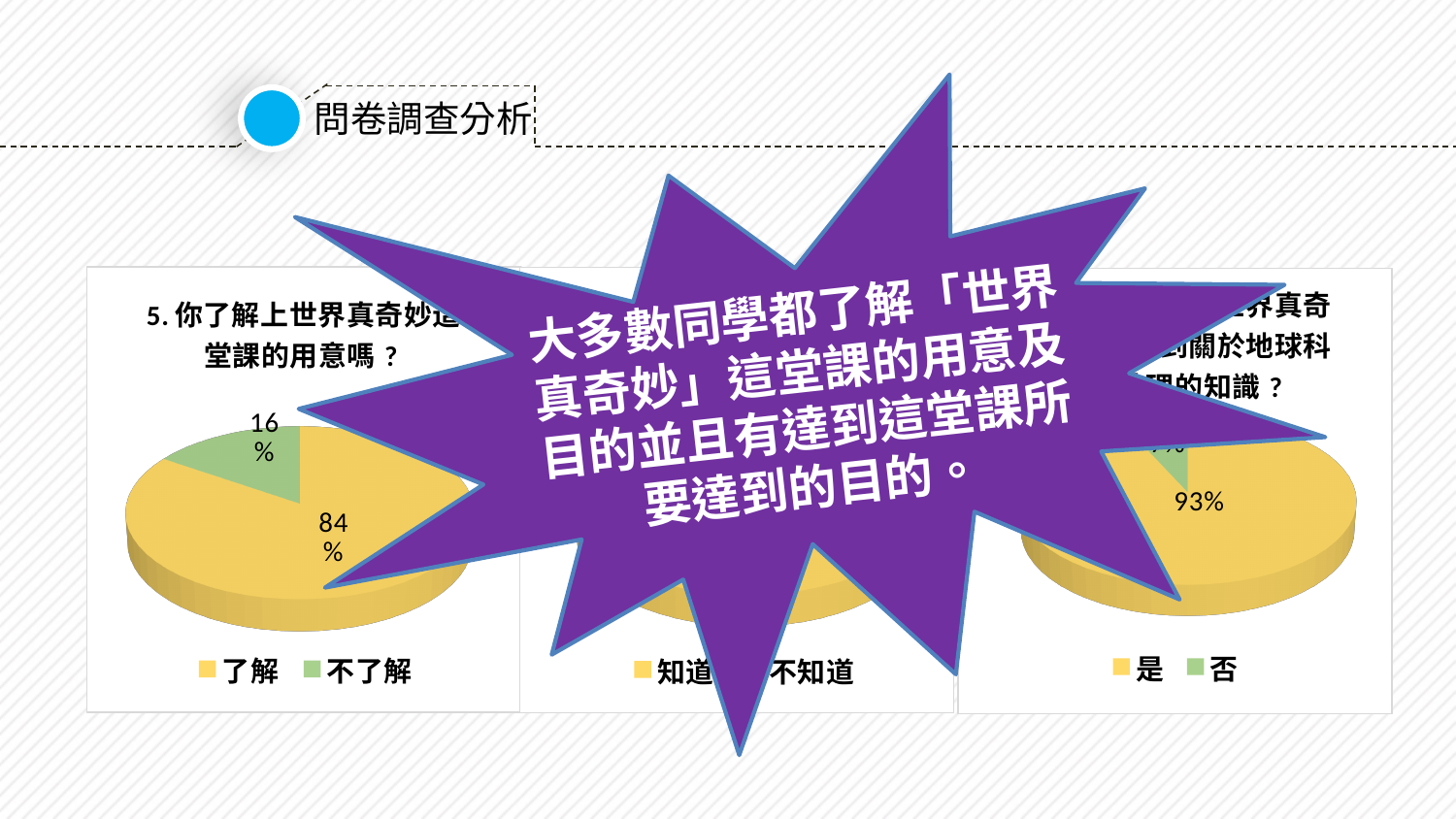
How many pie charts are shown on the slide? 3 On the left pie chart (question 5), which category has the largest share? 了解 On the right pie chart (with legend 是 / 否), which category has the largest share? 是 On the right pie chart (with legend 是 / 否), what percentage of students answered 是? 93% On the left pie chart (question 5), what percentage of students answered 不了解? 16% How many categories does the legend of the left pie chart (question 5) list? 2 On the left pie chart (question 5, 你了解上世界真奇妙這堂課的用意嗎), what percentage of students answered 了解? 84% What kind of chart is the left chart (question 5)? Pie chart On the left pie chart (question 5), which is larger: the share for 了解 or the share for 不了解? 了解 On the left pie chart (question 5), what is the difference in percentage points between 了解 and 不了解? 68 percentage points What are the two legend entries of the middle pie chart? 知道 and 不知道 On the left pie chart (question 5), which category has the smallest share? 不了解